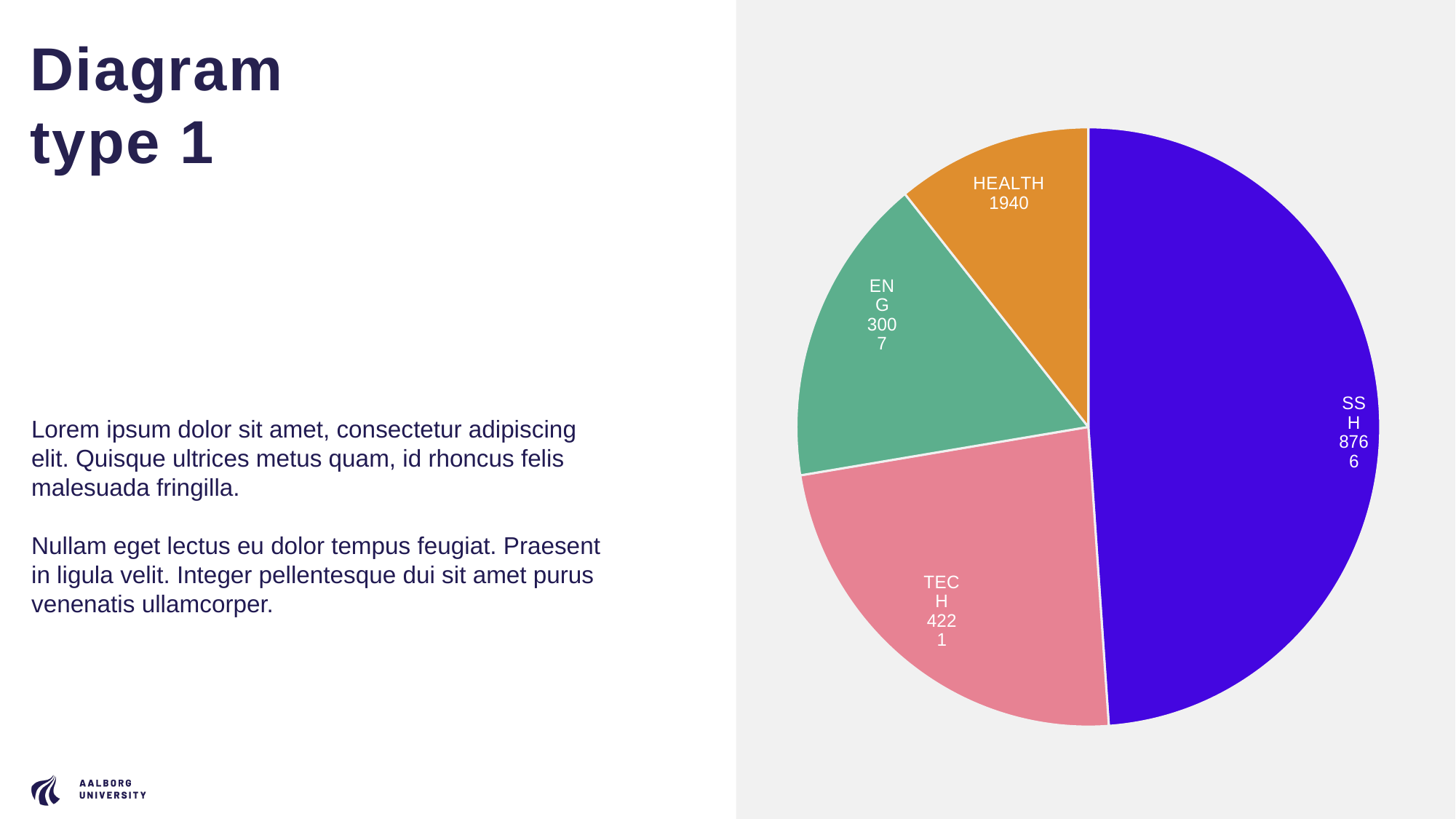
What colour is the SSH slice of the pie chart? Blue What is the difference between the SSH value and the TECH value in the pie chart? 4545 What value is shown for the SSH slice of the pie chart? 8766 What value is shown for the HEALTH slice of the pie chart? 1940 What value is shown for the ENG slice of the pie chart? 3007 How many slices does the pie chart have? 4 Which slice of the pie chart has the smallest value? HEALTH What kind of chart is shown on the slide? Pie chart What is the difference between the ENG value and the HEALTH value in the pie chart? 1067 Which is larger in the pie chart, TECH or ENG? TECH Which slice of the pie chart has the largest value? SSH What value is shown for the TECH slice of the pie chart? 4221